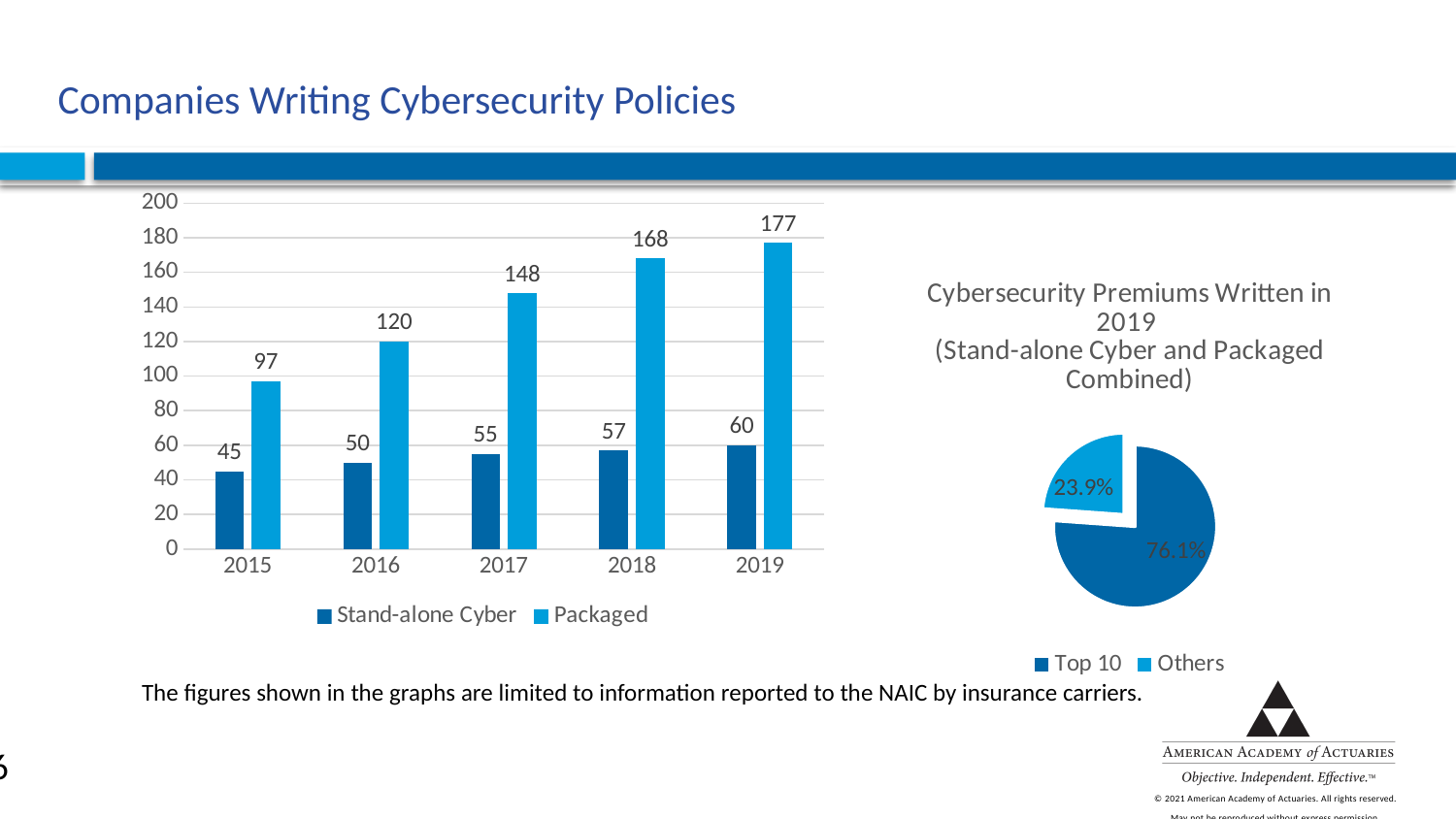
In the 'Cybersecurity Premiums Written in 2019' pie chart, what share is Others? 23.9% In the bar chart on the left, do the Packaged values rise or fall from 2015 to 2019? rise In the bar chart on the left, which is larger in 2016: Stand-alone Cyber or Packaged? Packaged In the 'Cybersecurity Premiums Written in 2019' pie chart, what share is Top 10? 76.1% In the bar chart on the left, which year has the highest Packaged value? 2019 In the bar chart on the left, what is the difference between the Packaged and Stand-alone Cyber values in 2019? 117 In the bar chart on the left, how many years are shown on the x axis? 5 In the bar chart on the left, how many series does the legend list? 2 What kind of chart is the 'Cybersecurity Premiums Written in 2019' chart on the right? pie chart In the bar chart on the left, what is the value for Packaged in 2017? 148 In the bar chart on the left, what is the value for Stand-alone Cyber in 2015? 45 In the bar chart on the left, which year has the lowest Stand-alone Cyber value? 2015